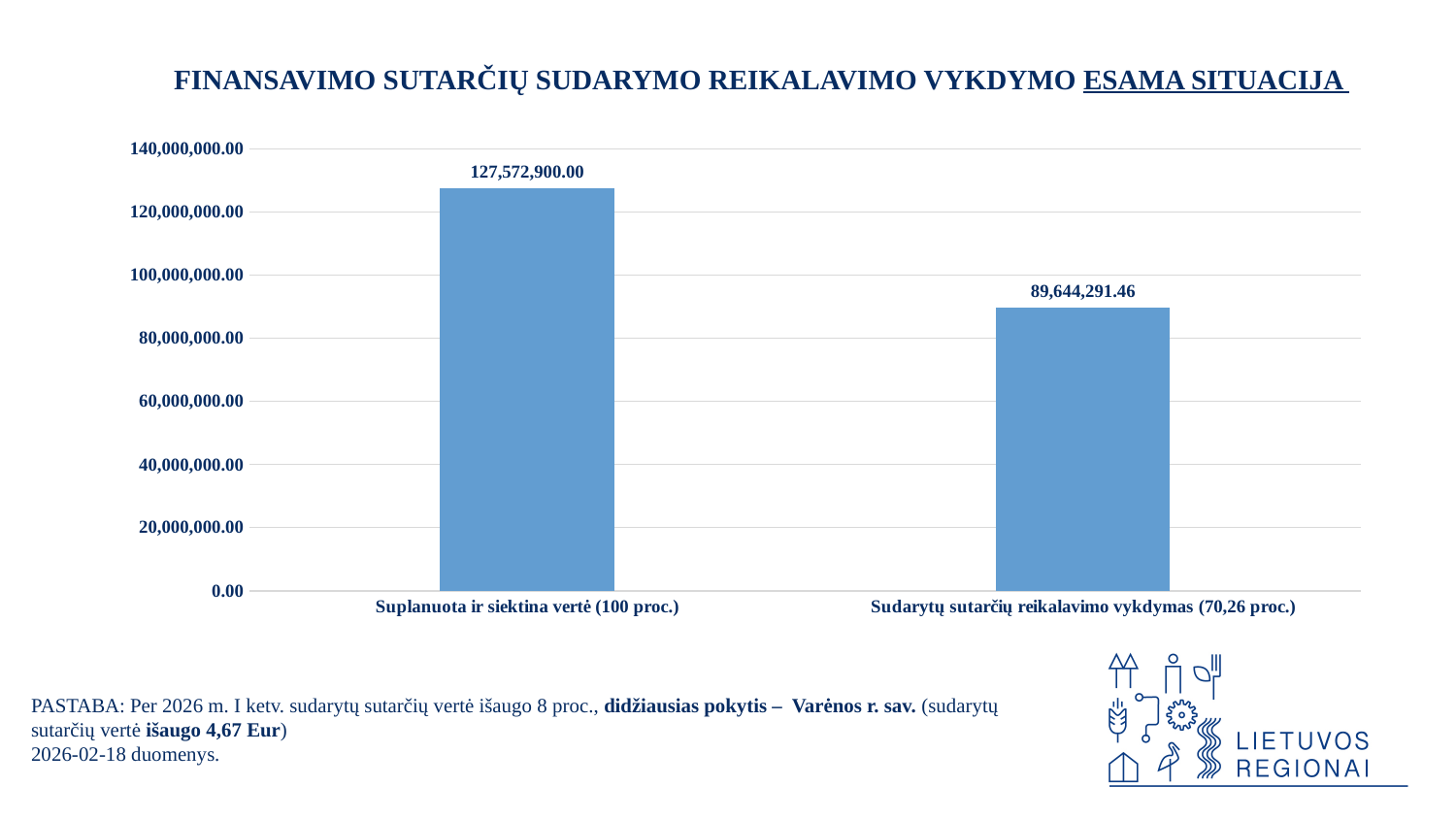
Is the value for "Suplanuota ir siektina vertė (100 proc.)" greater or less than 120,000,000.00? greater What is the value for "Suplanuota ir siektina vertė (100 proc.)"? 127,572,900.00 How many categories are shown in the chart? 2 Is the value for "Sudarytų sutarčių reikalavimo vykdymas (70,26 proc.)" greater or less than 100,000,000.00? less What is the value for "Sudarytų sutarčių reikalavimo vykdymas (70,26 proc.)"? 89,644,291.46 What kind of chart is shown on the slide? bar chart What is the difference between the value for "Suplanuota ir siektina vertė (100 proc.)" and the value for "Sudarytų sutarčių reikalavimo vykdymas (70,26 proc.)"? 37,928,608.54 Do the values rise or fall from the left bar to the right bar? fall Which category has the lowest value? Sudarytų sutarčių reikalavimo vykdymas (70,26 proc.) Which category has the highest value? Suplanuota ir siektina vertė (100 proc.) What is the title of the slide containing the chart? FINANSAVIMO SUTARČIŲ SUDARYMO REIKALAVIMO VYKDYMO ESAMA SITUACIJA Which is larger: the value for "Suplanuota ir siektina vertė (100 proc.)" or the value for "Sudarytų sutarčių reikalavimo vykdymas (70,26 proc.)"? Suplanuota ir siektina vertė (100 proc.)